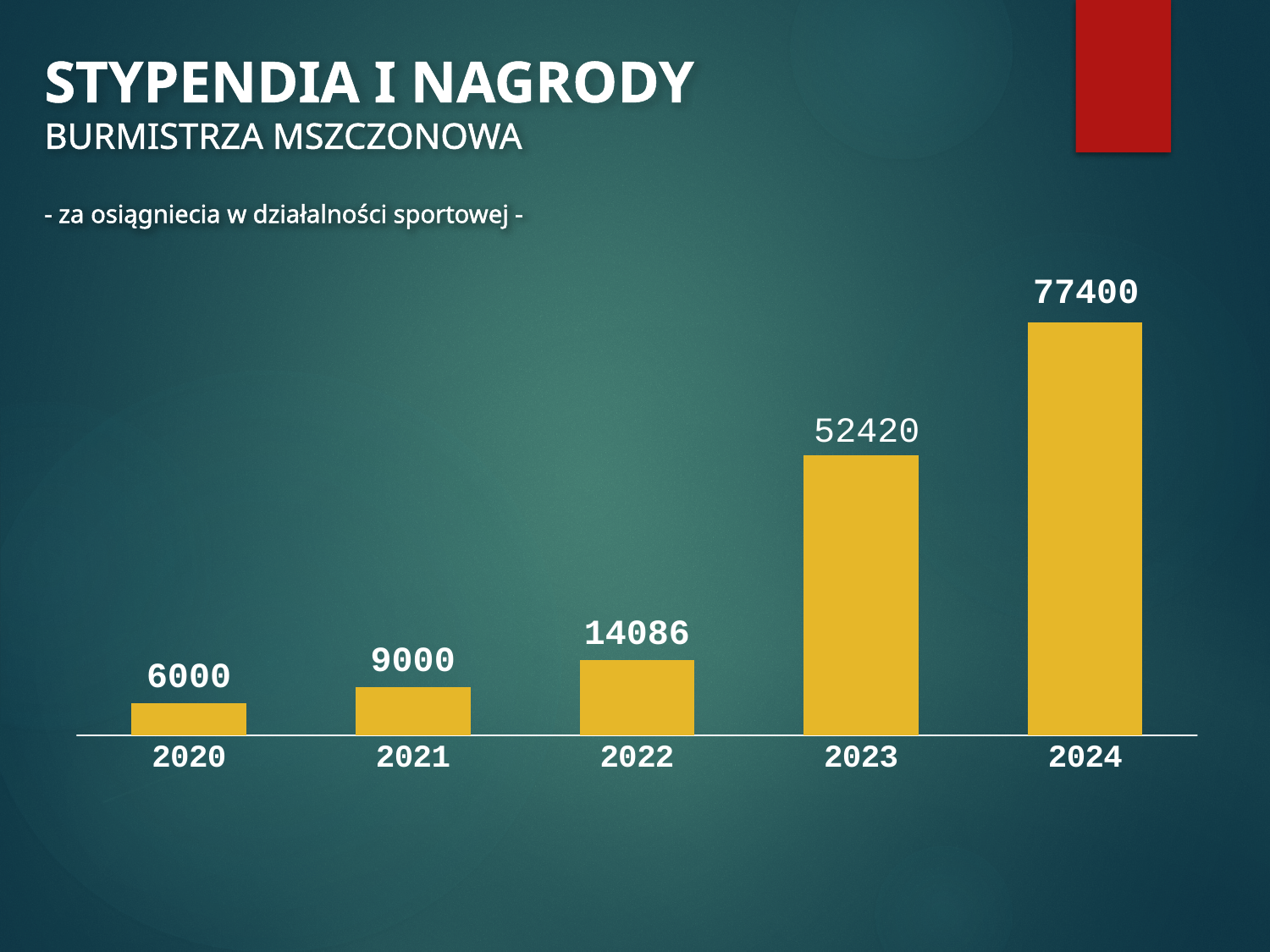
What is the difference between the values for 2024 and 2023? 24980 What is the value for 2023? 52420 What is the value for 2020? 6000 Which year has the highest value? 2024 What is the value for 2022? 14086 Do the values rise or fall from 2020 to 2024? rise What is the difference between the values for 2021 and 2020? 3000 What kind of chart is shown on the slide? bar chart What is the value for 2024? 77400 Which is larger, the value for 2022 or the value for 2021? 2022 Which year has the lowest value? 2020 How many years are shown on the chart? 5